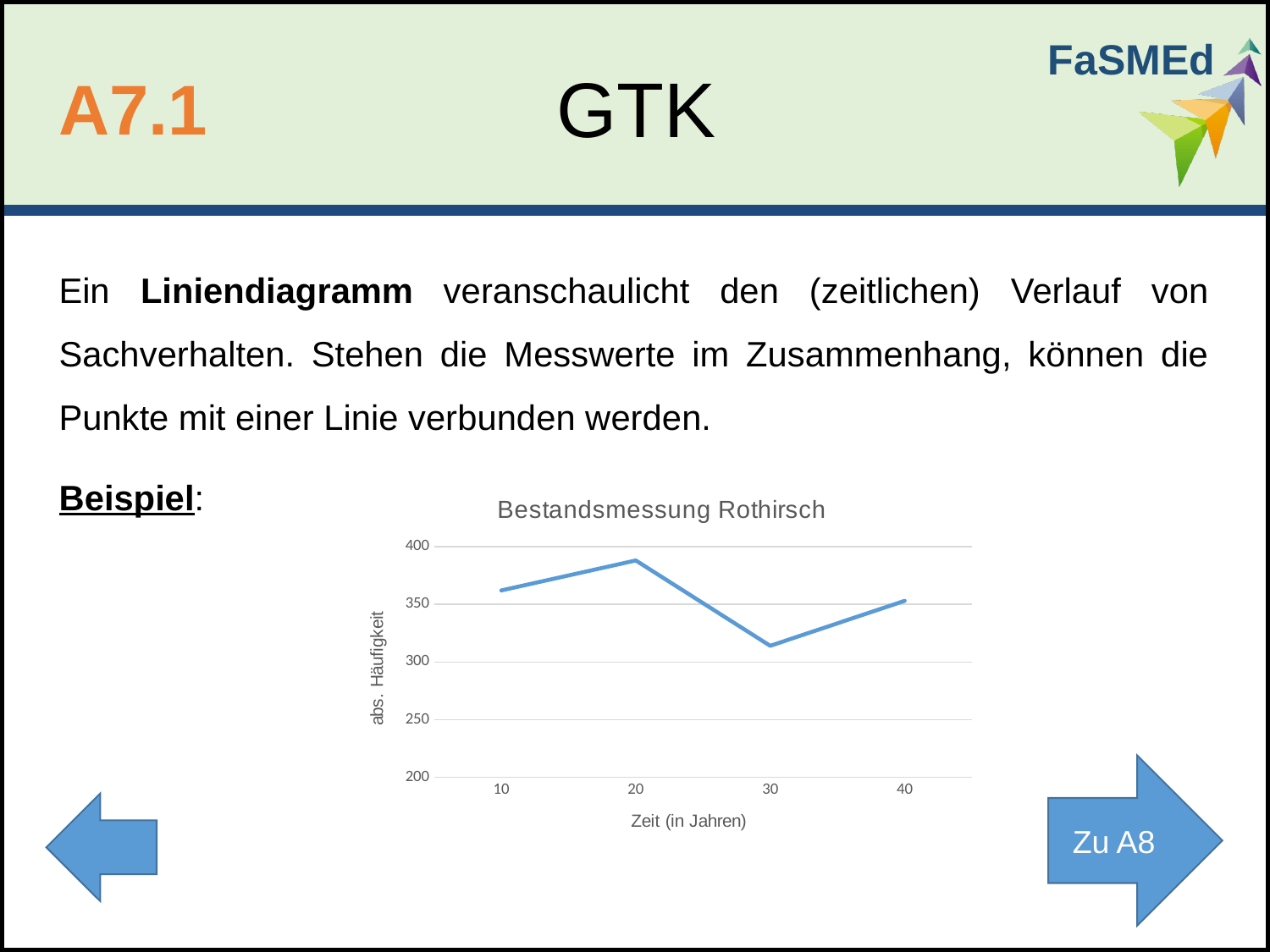
Does the value rise or fall from 20 years to 30 years? fall How many data points are plotted in the chart? 4 What is the label of the x axis of the chart? Zeit (in Jahren) Which is larger, the value at 20 years or the value at 30 years? 20 years Is the value at 20 years greater or less than 350? greater Is the value at 30 years greater or less than 300? greater At which time (in years) is the value highest? 20 At which time (in years) is the value lowest? 30 What kind of chart is shown on the slide? line chart Is the value at 10 years greater or less than 350? greater What is the title of the chart? Bestandsmessung Rothirsch